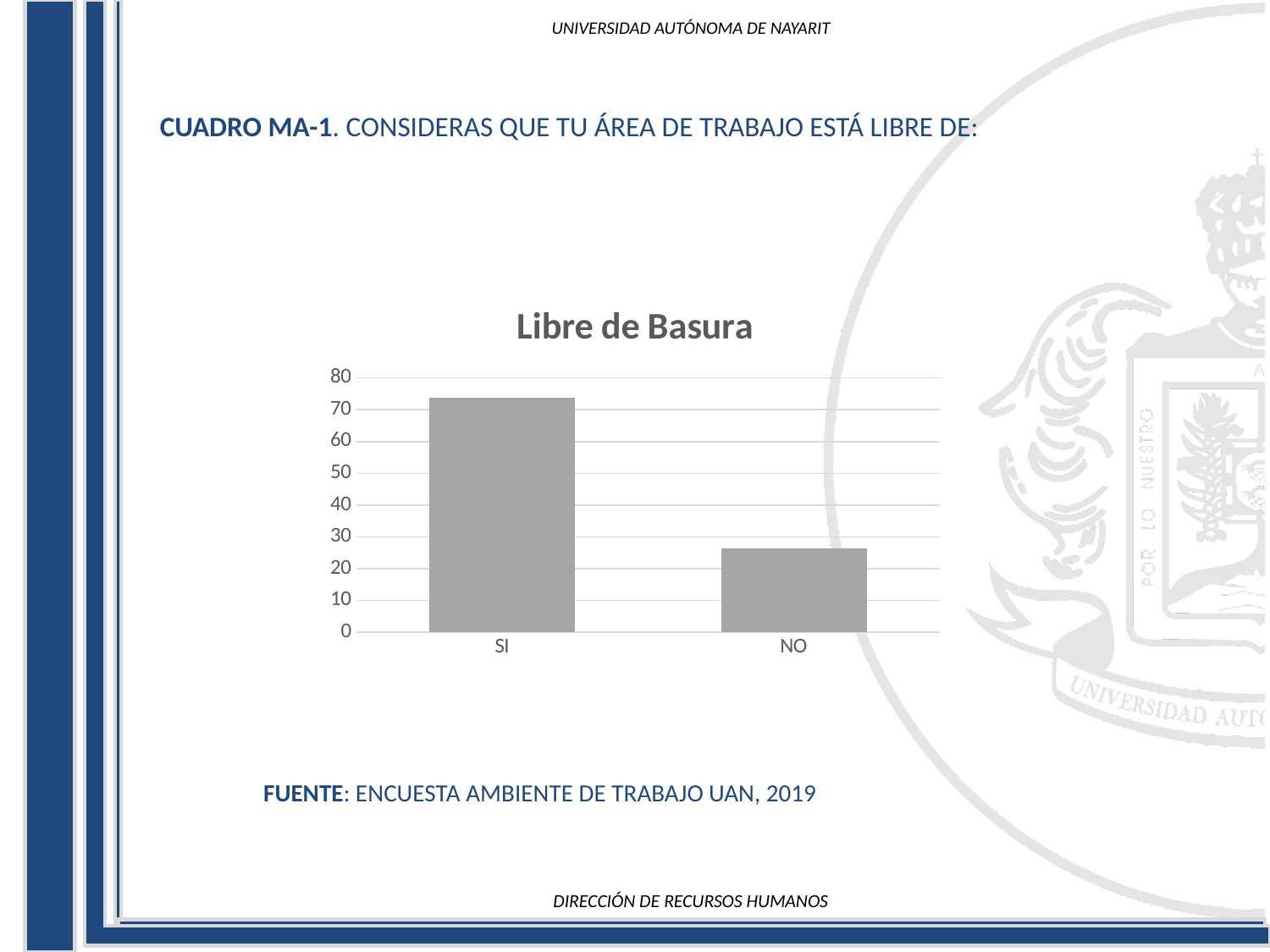
What is the title of the chart? Libre de Basura Is the value for SI greater or less than 70? greater What is the highest value shown on the y axis of the chart? 80 Is the value for SI greater or less than 80? less What kind of chart is shown on the slide? bar chart Which is larger, the value for SI or the value for NO? SI Which category has the highest value in the chart? SI How many categories are shown on the x axis of the chart? 2 Which category has the lowest value in the chart? NO Is the value for NO greater or less than 20? greater